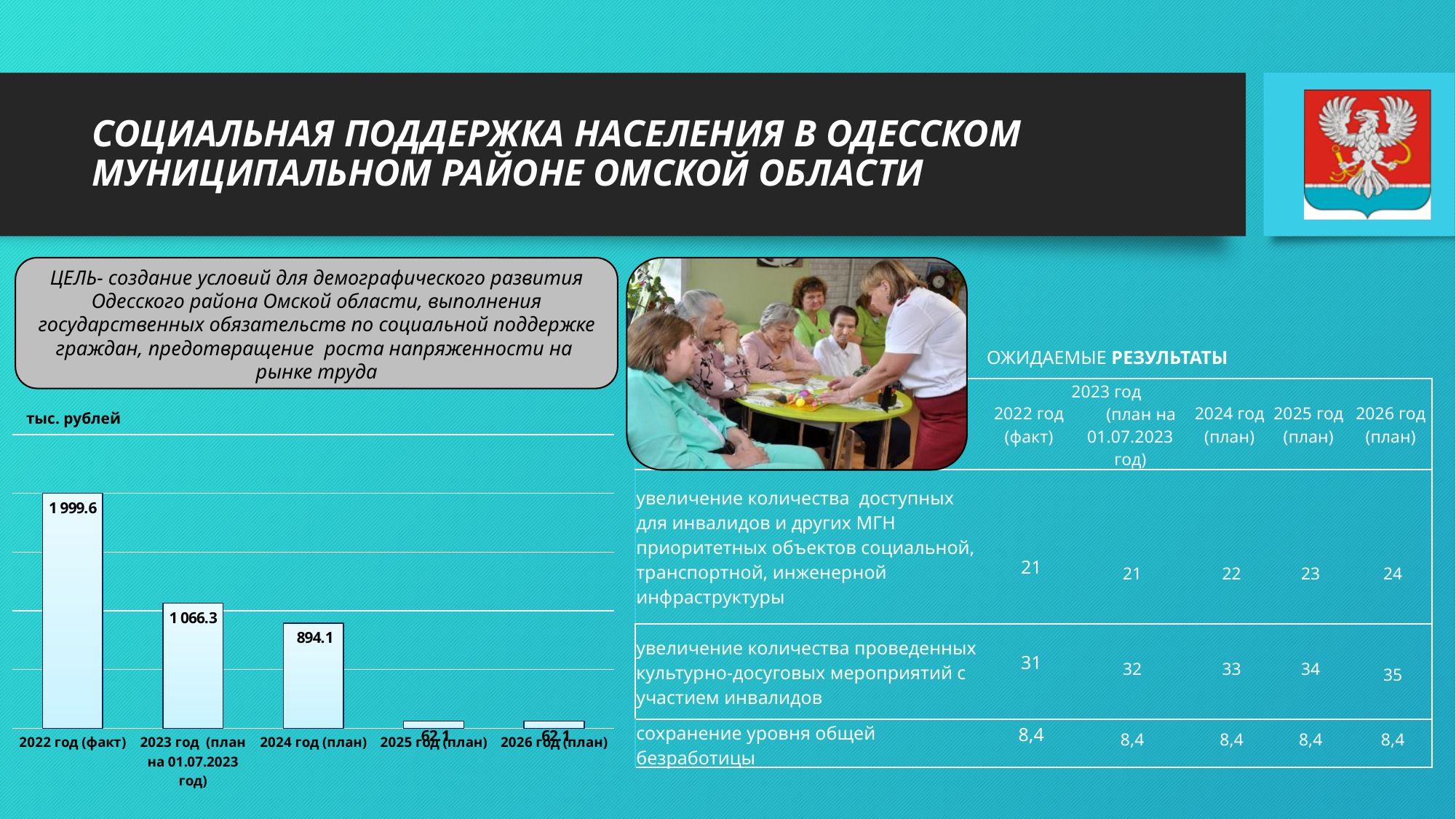
How many categories are shown in the bar chart? 5 What kind of chart is shown on the left of the slide? Bar chart What is the value for 2023 год (план на 01.07.2023 год) in the bar chart? 1 066.3 What is the difference between the values for 2022 год (факт) and 2023 год (план на 01.07.2023 год)? 933.3 Which is larger in the bar chart: the value for 2024 год (план) or the value for 2025 год (план)? 2024 год (план) What is the difference between the values for 2023 год (план на 01.07.2023 год) and 2024 год (план)? 172.2 What is the value for 2025 год (план) in the bar chart? 62.1 What is the lowest value shown in the bar chart? 62.1 What is the value for 2022 год (факт) in the bar chart? 1 999.6 Which category has the highest value in the bar chart? 2022 год (факт) Do the values in the bar chart rise or fall from 2022 to 2026? Fall What is the value for 2024 год (план) in the bar chart? 894.1